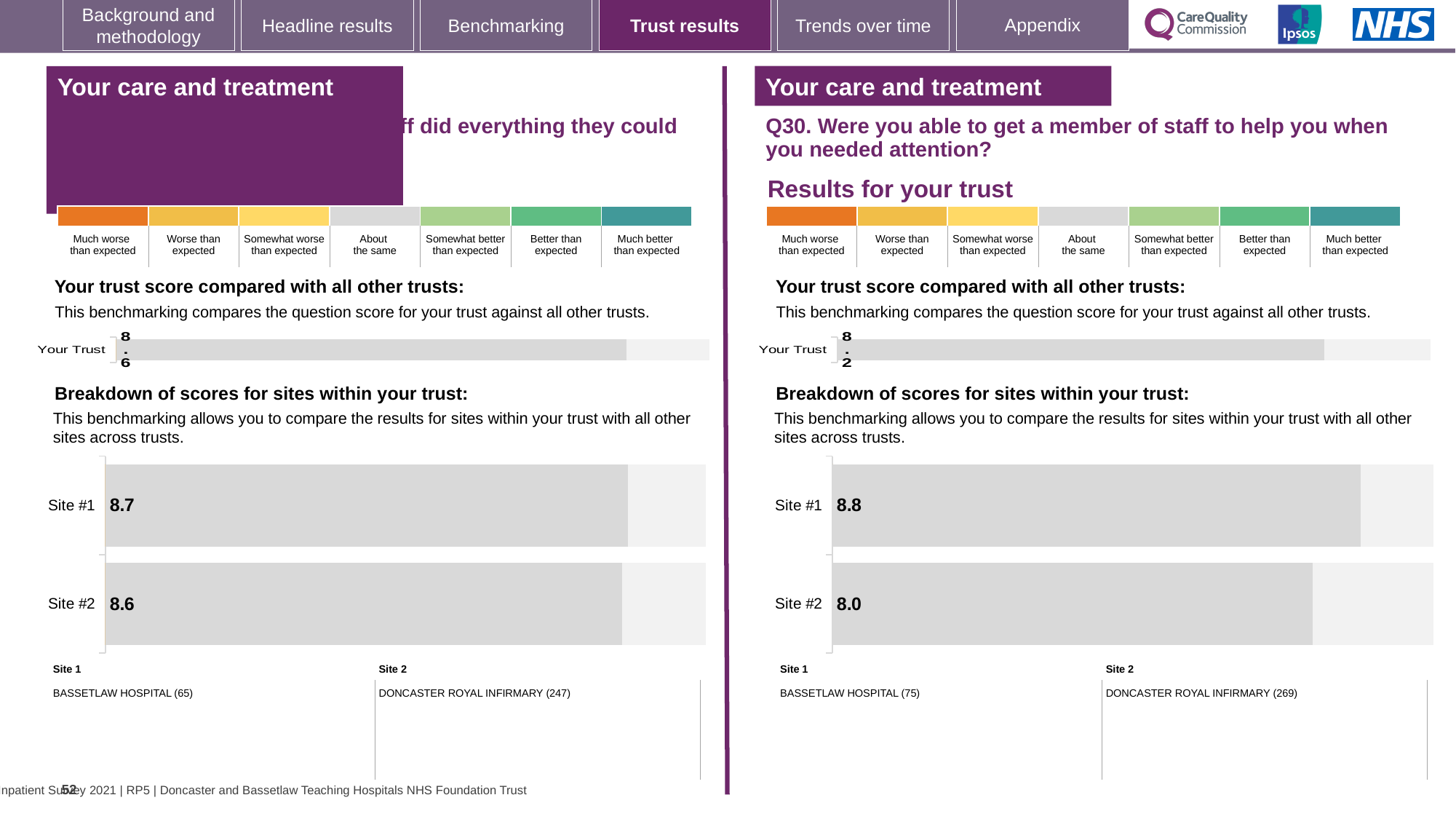
On the right-hand chart for Q30, which site has the higher score? Site #1 On the left-hand site breakdown chart, what is the score for Site #1? 8.7 On the right-hand chart for Q30, is the score for Site #1 larger or smaller than the score for Site #2? larger On the right-hand chart for Q30, what is the score for Site #1? 8.8 On the left-hand 'Your trust score compared with all other trusts' chart, what is the score for Your Trust? 8.6 On the right-hand 'Your trust score compared with all other trusts' chart for Q30, what is the score for Your Trust? 8.2 On the right-hand chart for Q30, what is the score for Site #2? 8.0 How many sites are shown in the right-hand site breakdown chart for Q30? 2 On the right-hand chart for Q30, what is the difference between the Site #1 and Site #2 scores? 0.8 On the left-hand site breakdown chart, what is the score for Site #2? 8.6 On the left-hand site breakdown chart, what is the difference between the Site #1 and Site #2 scores? 0.1 What type of chart is used for the site breakdown on the right-hand side of the slide? bar chart